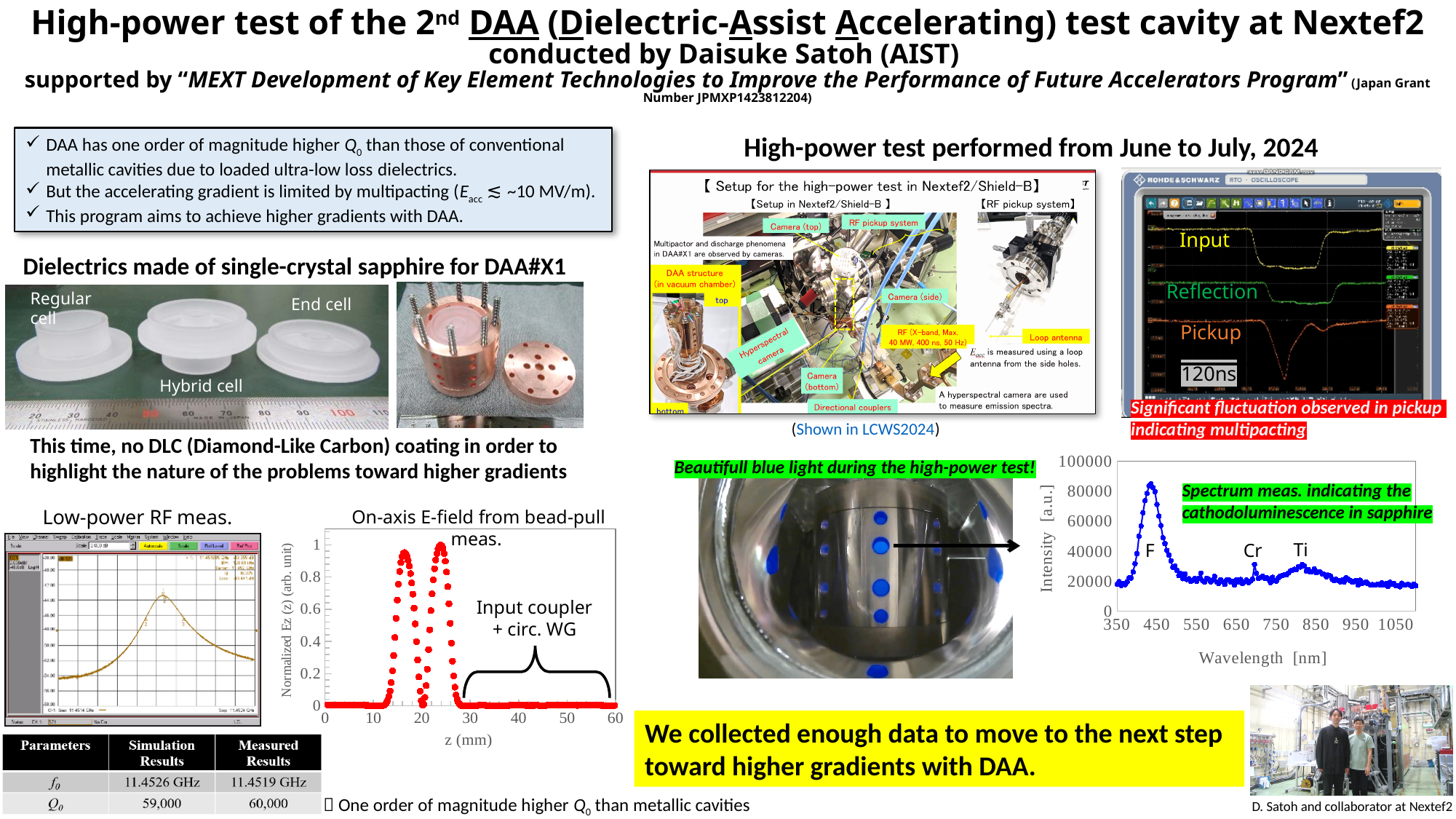
In the 'On-axis E-field from bead-pull meas.' chart, what is the label of the x axis? z (mm) In the spectrum chart (Intensity vs Wavelength), is the intensity at 1050 nm greater or less than 40000? less In the spectrum chart (Intensity vs Wavelength), is the intensity of the F peak greater or less than 60000? greater In the 'On-axis E-field from bead-pull meas.' chart, how many peaks does the normalized Ez profile show? 2 In the 'On-axis E-field from bead-pull meas.' chart, is the normalized Ez value at z = 40 mm greater or less than 0.2? less What kind of chart is the 'On-axis E-field from bead-pull meas.' chart? scatter chart In the spectrum chart (Intensity vs Wavelength), how many labeled peaks are marked on the curve? 3 In the spectrum chart (Intensity vs Wavelength), which labeled peak has the highest intensity? F In the spectrum chart (Intensity vs Wavelength), which is larger, the intensity of the F peak or the intensity of the Cr peak? F In the spectrum chart, what is the unit shown on the x axis? nm In the 'On-axis E-field from bead-pull meas.' chart, what is the highest value shown on the x axis? 60